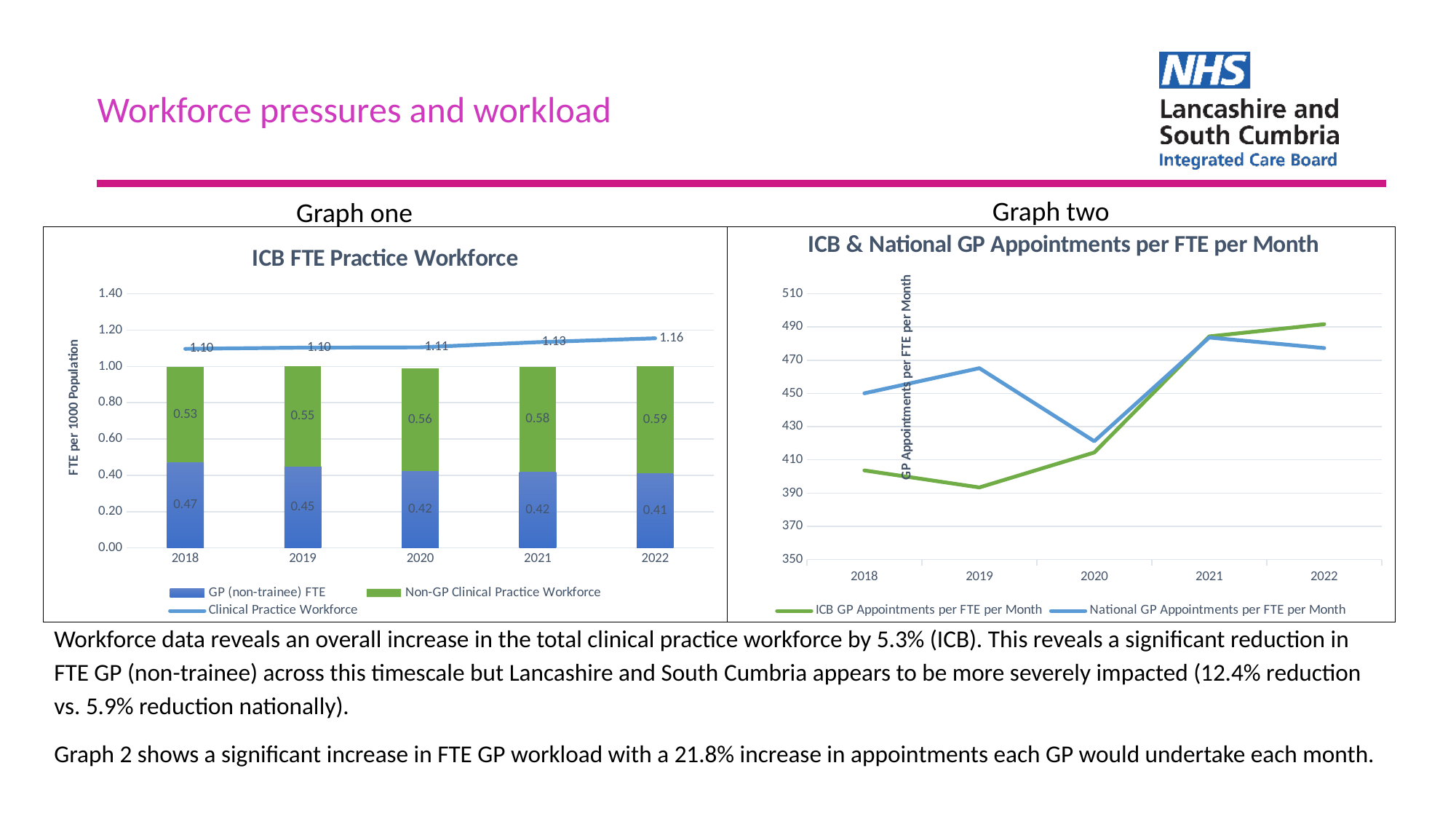
In Graph one (ICB FTE Practice Workforce), what is the GP (non-trainee) FTE value for 2018? 0.47 In Graph one (ICB FTE Practice Workforce), what is the difference between the Non-GP Clinical Practice Workforce values for 2022 and 2018? 0.06 In Graph two (ICB & National GP Appointments per FTE per Month), which year has the highest ICB GP Appointments per FTE per Month value? 2022 In Graph two (ICB & National GP Appointments per FTE per Month), is the National GP Appointments per FTE per Month value for 2018 greater or less than 430? greater In Graph one (ICB FTE Practice Workforce), does the GP (non-trainee) FTE value rise or fall from 2018 to 2022? Fall In Graph one (ICB FTE Practice Workforce), how many series does the legend list? 3 In Graph two (ICB & National GP Appointments per FTE per Month), in 2018, which series has the larger value: ICB or National GP Appointments per FTE per Month? National GP Appointments per FTE per Month In Graph one (ICB FTE Practice Workforce), what is the Non-GP Clinical Practice Workforce value for 2022? 0.59 In Graph two (ICB & National GP Appointments per FTE per Month), is the ICB GP Appointments per FTE per Month value for 2019 greater or less than 410? less In Graph one (ICB FTE Practice Workforce), what is the Clinical Practice Workforce value for 2021? 1.13 In Graph one (ICB FTE Practice Workforce), which year has the lowest GP (non-trainee) FTE value? 2022 In Graph two (ICB & National GP Appointments per FTE per Month), what kind of chart is shown? Line chart